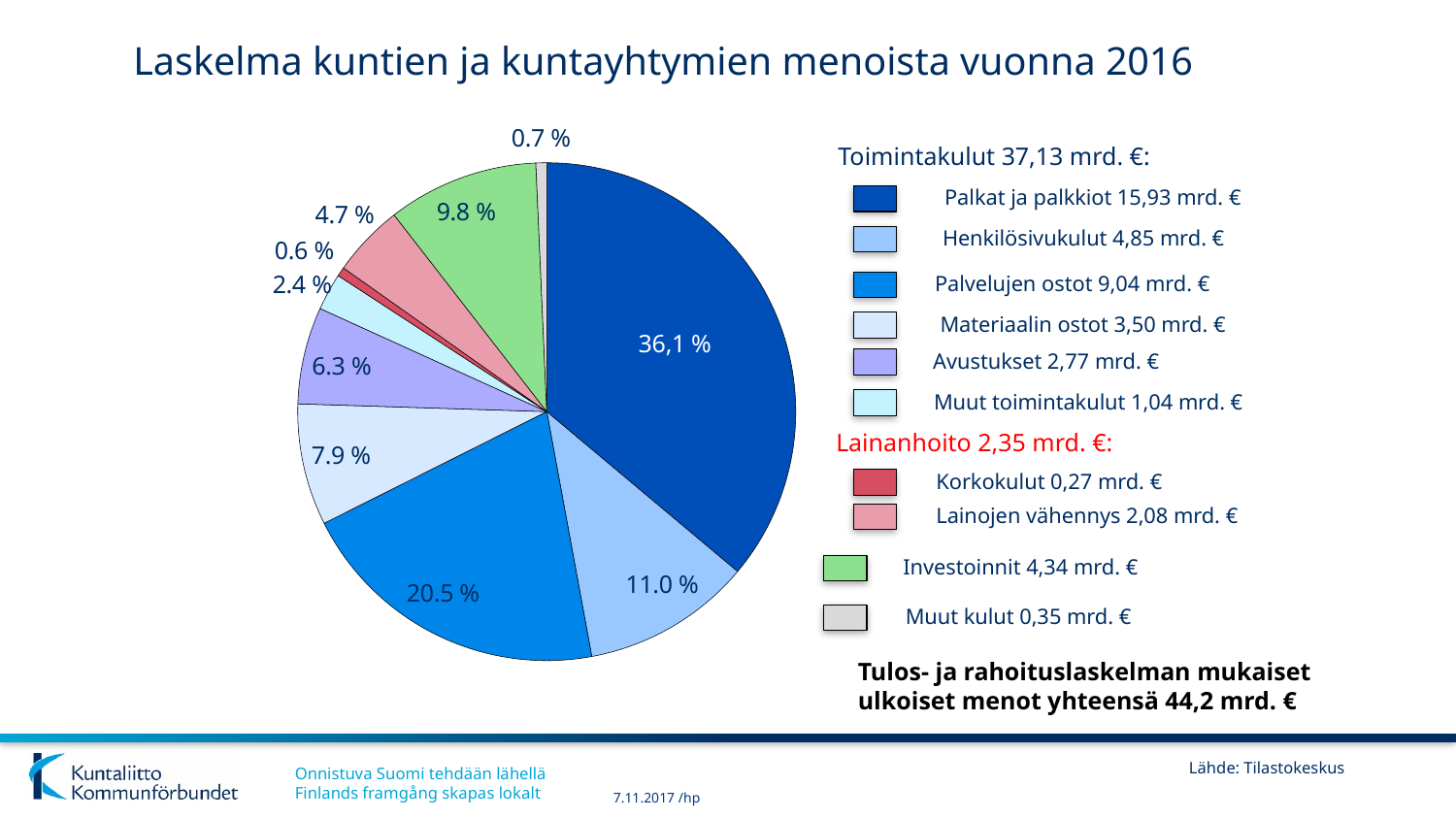
What share of the pie does Muut kulut represent? 0.7 % What kind of chart is shown on the slide? pie chart What is the value for Lainanhoito? 2,35 mrd. € How many slices does the pie chart have? 10 Which is larger, Investoinnit or Lainojen vähennys? Investoinnit What is the total for Toimintakulut shown on the slide? 37,13 mrd. € What is the value for Palkat ja palkkiot according to the legend? 15,93 mrd. € What share of the pie does Palvelujen ostot represent? 20.5 % Which category has the smallest slice of the pie? Korkokulut What is the title of the slide? Laskelma kuntien ja kuntayhtymien menoista vuonna 2016 Which category has the largest slice of the pie? Palkat ja palkkiot What is the difference between Palkat ja palkkiot and Henkilösivukulut in mrd. €? 11,08 mrd. €